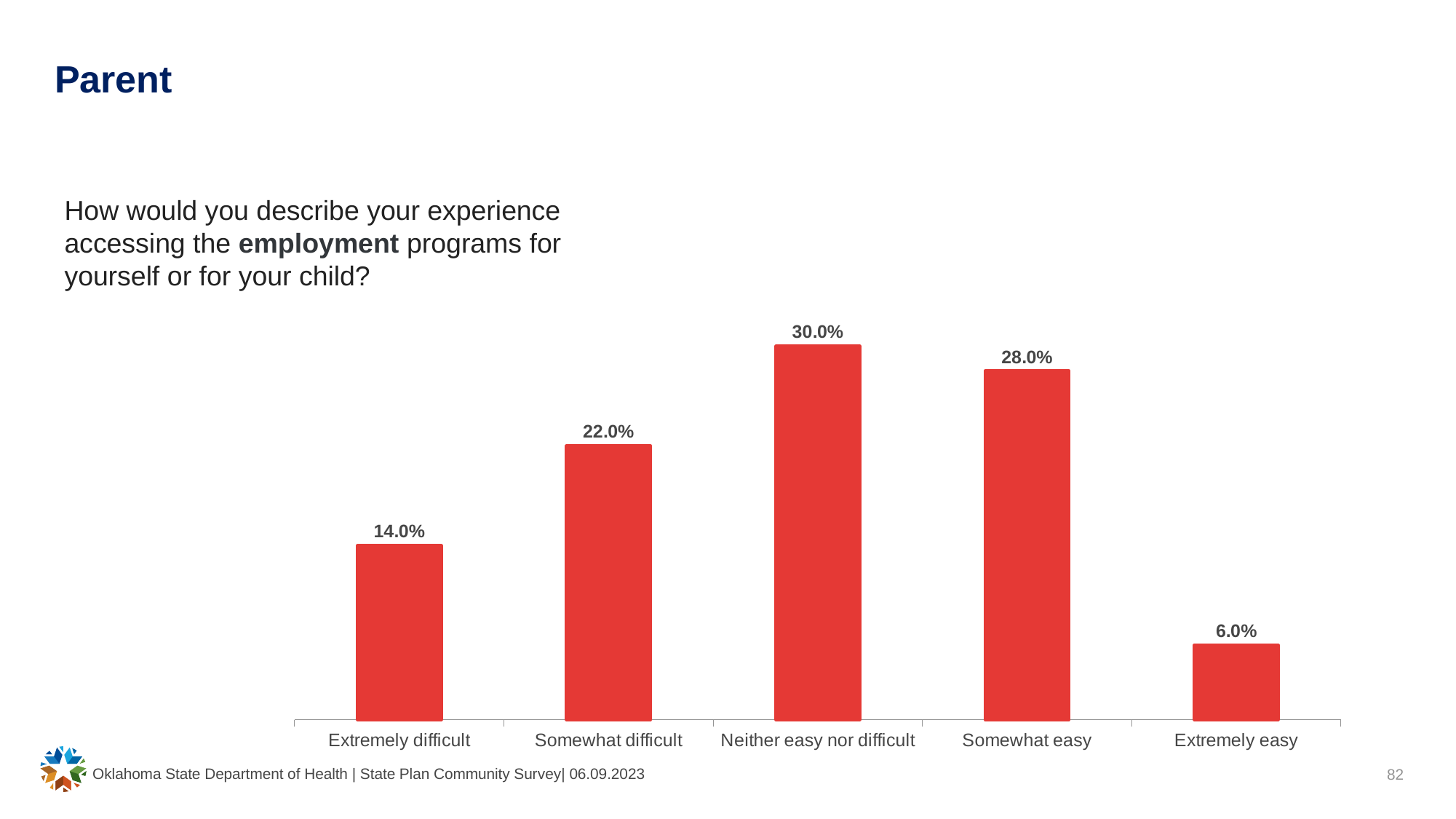
What is the difference between the values for Somewhat easy and Somewhat difficult? 6.0% What kind of chart is shown on the slide? Bar chart What is the value for Extremely difficult? 14.0% What is the value for Somewhat difficult? 22.0% What is the difference between the values for Neither easy nor difficult and Extremely easy? 24.0% Which is larger, the value for Somewhat difficult or the value for Extremely difficult? Somewhat difficult What is the value for Somewhat easy? 28.0% What is the value for Extremely easy? 6.0% What is the value for Neither easy nor difficult? 30.0% Which category has the lowest value? Extremely easy Which category has the highest value? Neither easy nor difficult How many categories are shown on the chart? 5